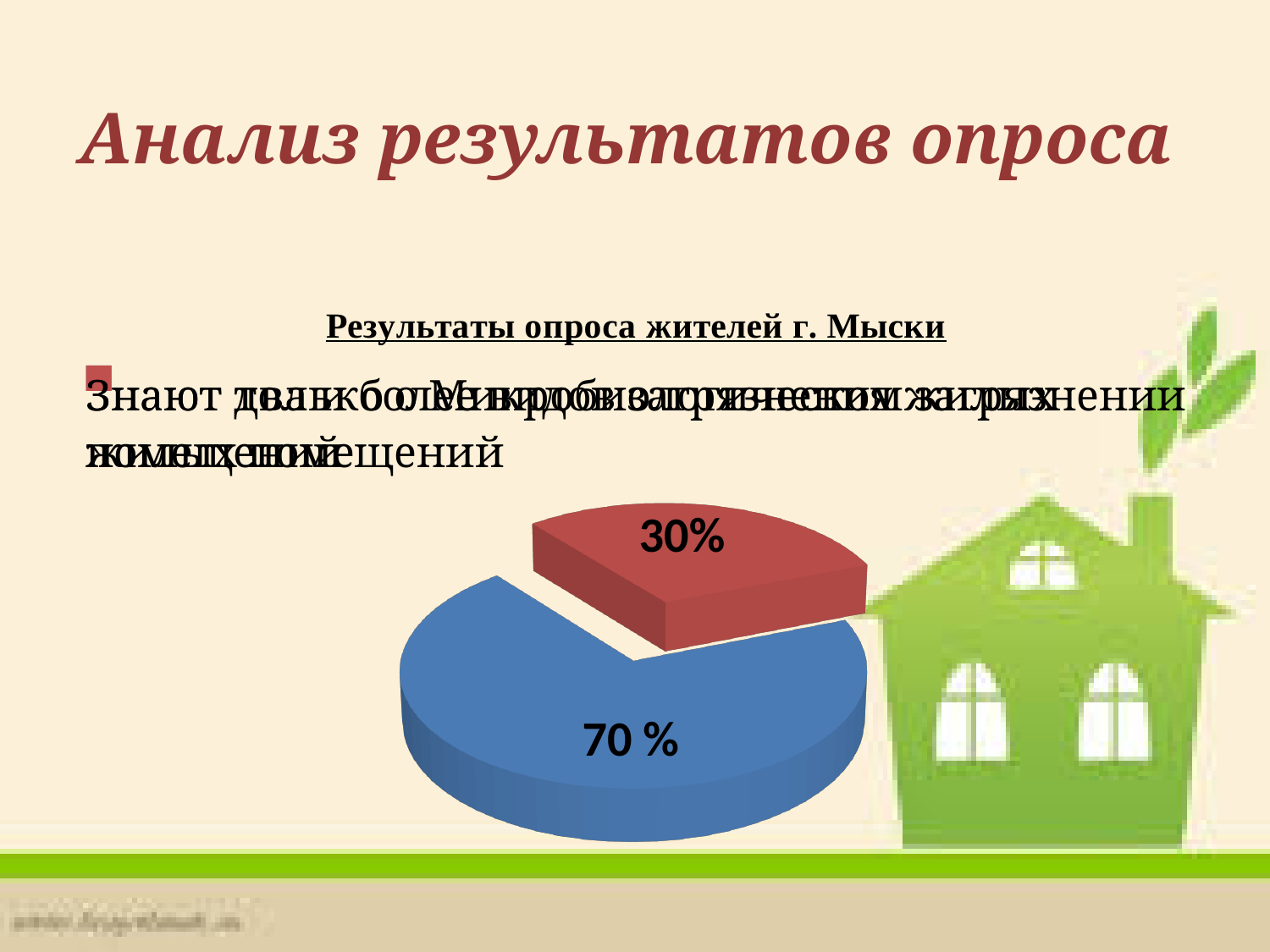
What kind of chart is shown on the slide? pie chart How many slices does the pie chart have? 2 Which slice of the pie chart is the smallest? the red slice (30%) Which slice of the pie chart is the largest? the blue slice (70 %) What share of the pie does the red slice represent? 30% What value is printed on the red slice of the pie chart? 30% What is the title of the chart? Результаты опроса жителей г. Мыски Which is larger, the blue slice or the red slice? the blue slice Which slice of the pie chart is pulled out (exploded) from the rest? the red slice (30%) What value is printed on the blue slice of the pie chart? 70 % What is the difference in percentage points between the blue slice and the red slice? 40